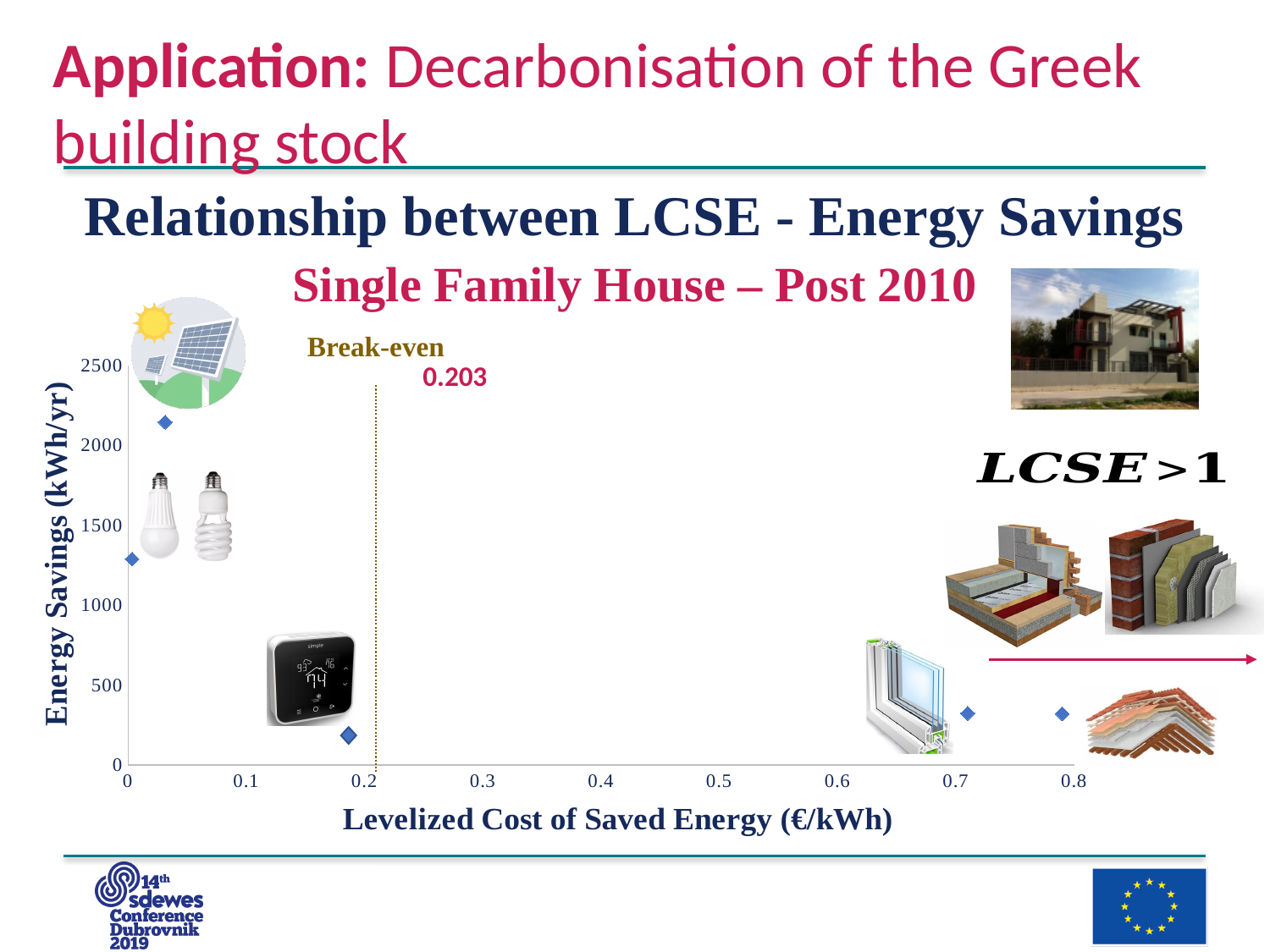
Is the energy savings value of the point plotted just left of the break-even line greater or less than 500? less What kind of chart is shown on the slide? scatter chart Is the point with the highest energy savings located to the left or to the right of the break-even line? left How many data points are plotted on the chart? 5 Is the energy savings value of the point plotted at an LCSE of 0 greater or less than 1000? greater How many plotted points lie to the right of the break-even line? 2 Which has higher energy savings: the point plotted at an LCSE of 0 or the point plotted near an LCSE of 0.8? the point at an LCSE of 0 What is the title of the chart's y axis? Energy Savings (kWh/yr) What break-even value is marked on the chart? 0.203 What is the title of the chart's x axis? Levelized Cost of Saved Energy (€/kWh) Is the energy savings value of the point plotted near an LCSE of 0.7 greater or less than 500? less